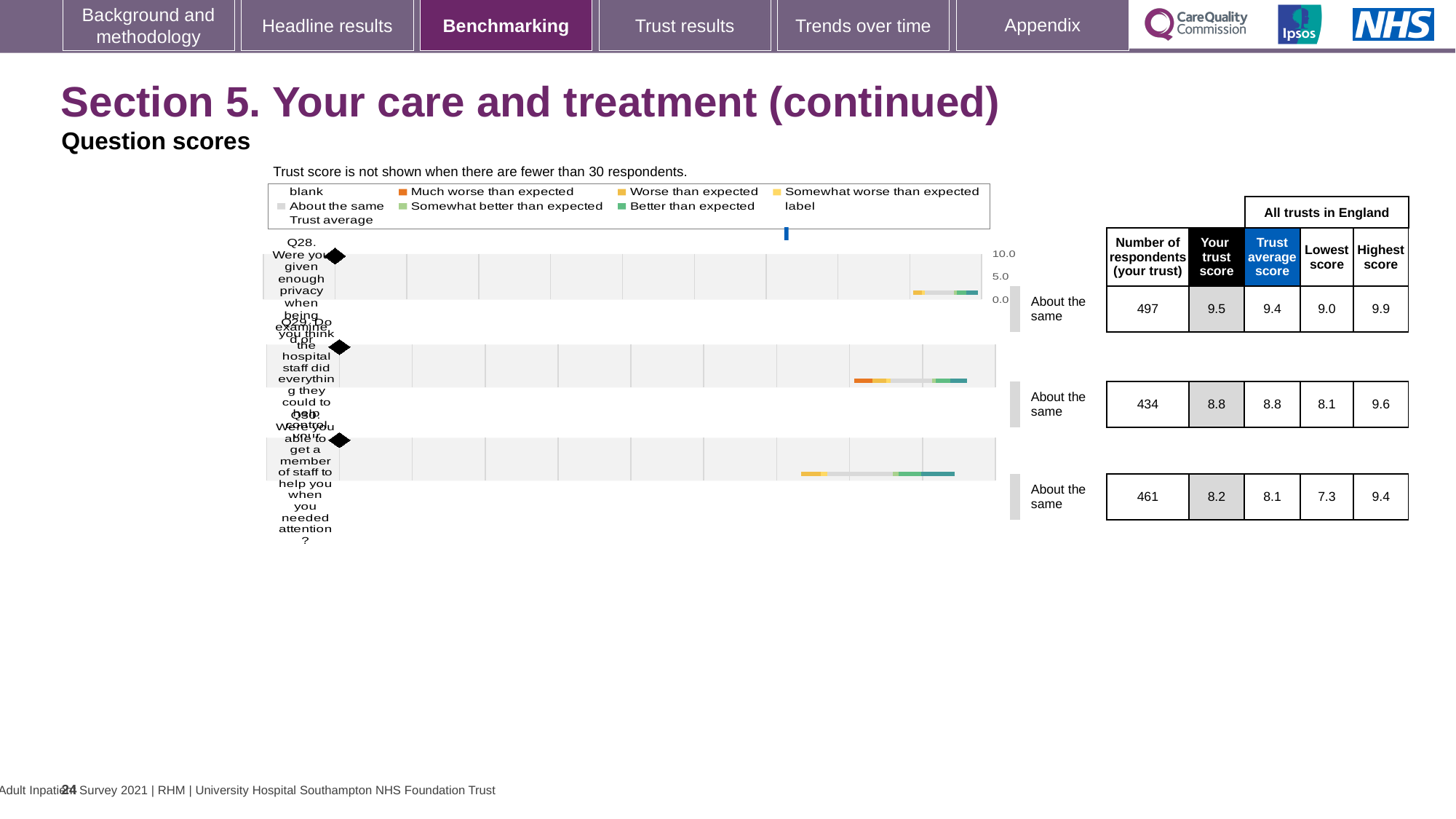
What is the lowest score across all trusts in England for Q29? 8.1 Is the trust score marker for Q28 greater or less than 5.0 on the chart axis? greater Which question has the highest trust score on the slide? Q28 How many questions (Q28, Q29, Q30) are plotted on the slide? 3 What kind of chart is used to show the question scores for Q28, Q29 and Q30? bar chart What is the highest score across all trusts in England for Q30? 9.4 Which has the larger trust score, Q28 or Q29? Q28 How many respondents answered Q29 for the trust? 434 What benchmark category is shown next to the chart for Q28? About the same Which question has the lowest trust score on the slide? Q30 What is the difference between the trust score for Q28 and the trust score for Q30? 1.3 What is the trust score for Q28 (Were you given enough privacy when being examined or treated)? 9.5